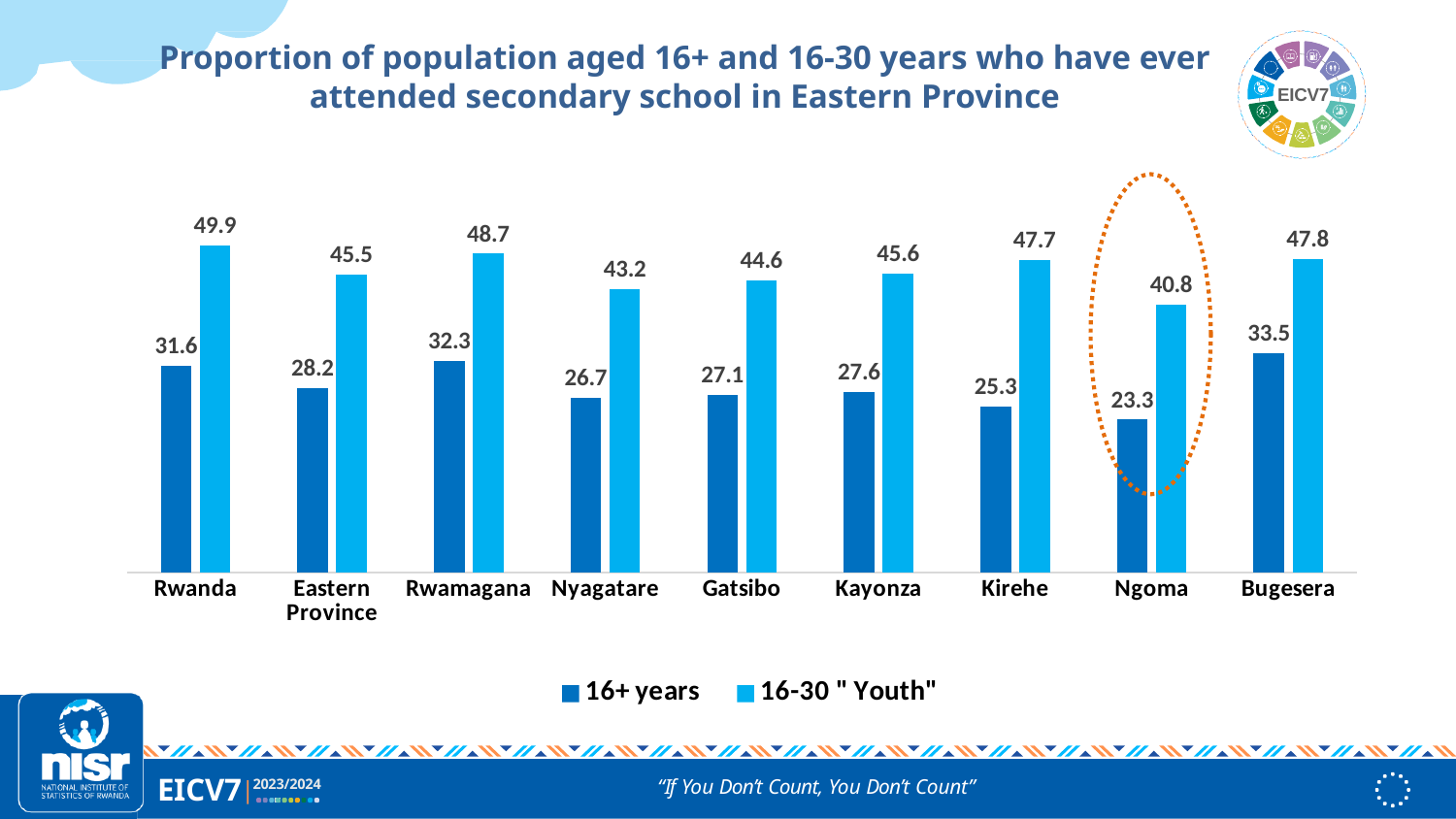
Which category has the highest value for the 16-30 "Youth" series? Rwanda What kind of chart is shown on the slide? Bar chart Which is larger, the 16+ years value for Rwamagana or the 16+ years value for Nyagatare? Rwamagana Which category has the lowest value for the 16+ years series? Ngoma What is the difference between the 16-30 "Youth" value and the 16+ years value for Rwanda? 18.3 What is the difference between the 16-30 "Youth" value and the 16+ years value for Kirehe? 22.4 How many series does the legend list? 2 What is the value for the 16+ years series in Ngoma? 23.3 How many categories are shown on the x axis? 9 Which category has the highest value for the 16+ years series? Bugesera What is the value for the 16-30 "Youth" series in Kirehe? 47.7 What is the value for the 16+ years series in Eastern Province? 28.2